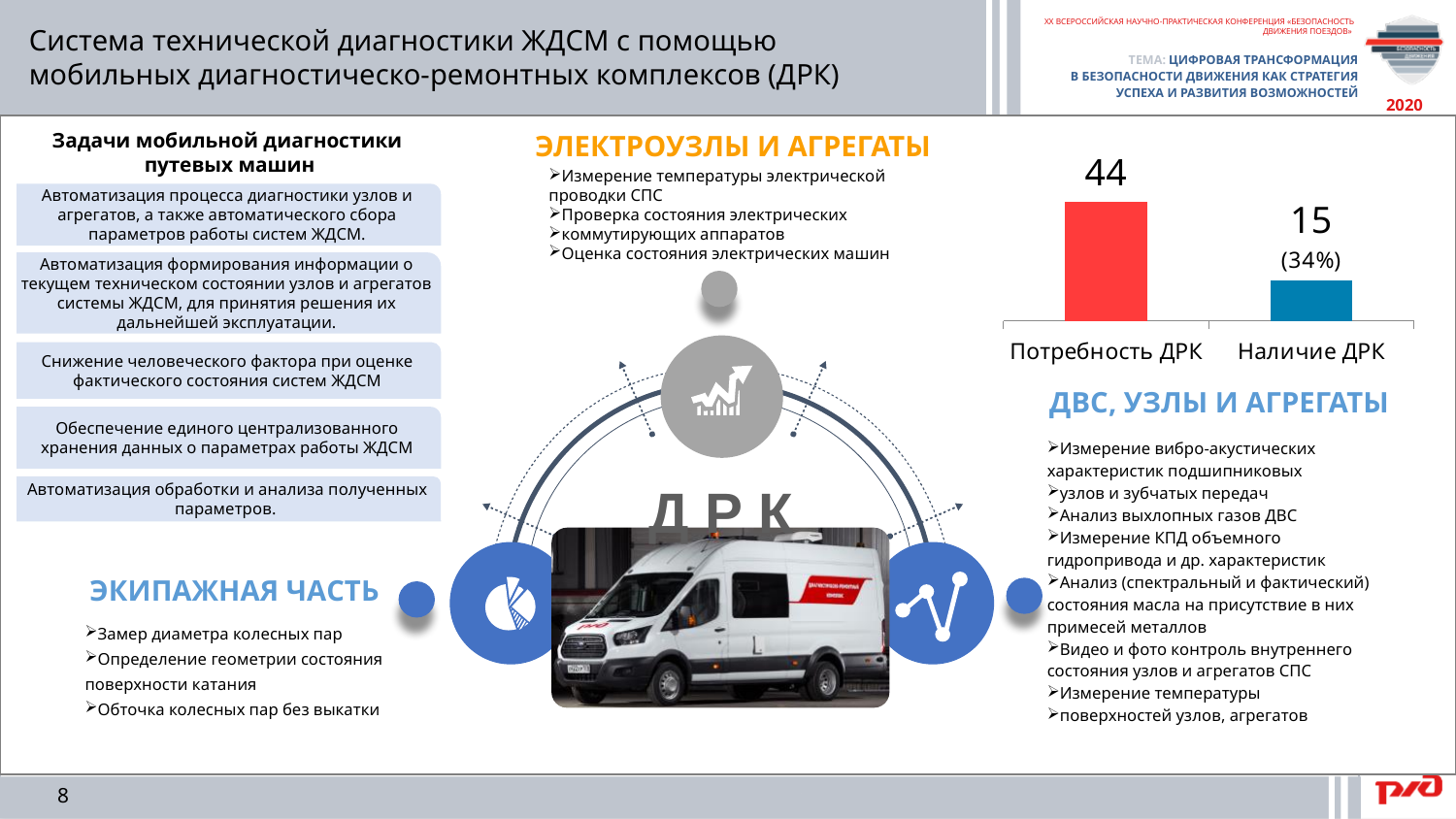
Which is larger, the value for Потребность ДРК or the value for Наличие ДРК? Потребность ДРК What is the difference between the values for Потребность ДРК and Наличие ДРК? 29 What colour is the bar for Наличие ДРК? blue Which category has the highest value in the bar chart? Потребность ДРК What kind of chart is shown on the slide? bar chart What is the value for Потребность ДРК in the bar chart? 44 What is the value for Наличие ДРК in the bar chart? 15 What colour is the bar for Потребность ДРК? red What percentage is shown next to the Наличие ДРК bar? 34% How many categories are shown in the bar chart? 2 Which category has the lowest value in the bar chart? Наличие ДРК